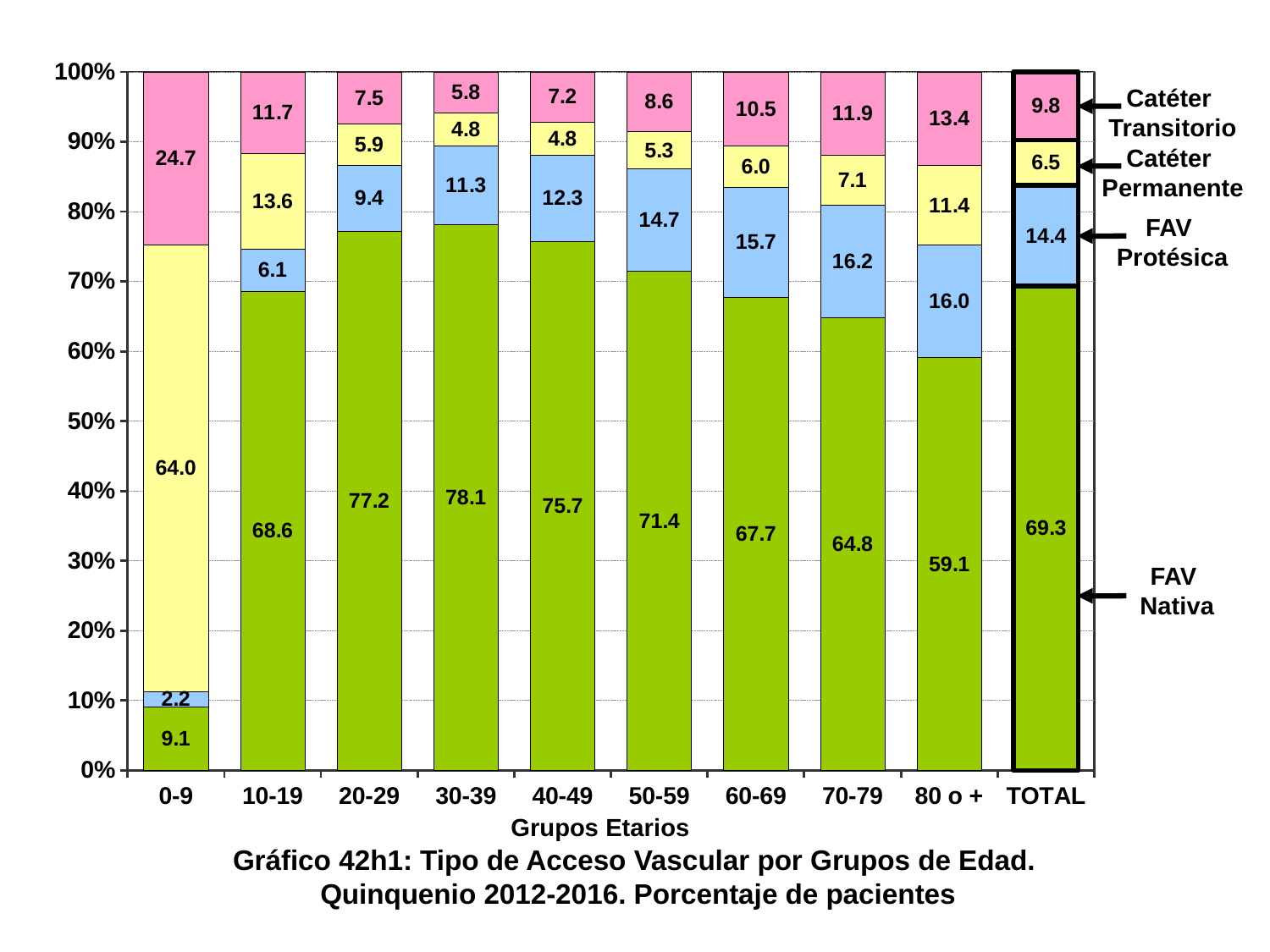
What is the FAV Nativa value for the 30-39 age group? 78.1 How many series (access types) are labelled on the chart? 4 What is the x-axis title of the chart? Grupos Etarios What kind of chart is this? Stacked bar chart Which age group has the lowest FAV Nativa value? 0-9 Which age group has the highest FAV Nativa value? 30-39 What is the difference between the FAV Nativa values for 20-29 and 80 o +? 18.1 What is the Catéter Transitorio value for the 0-9 age group? 24.7 How many bars are shown on the x axis, including TOTAL? 10 From the 30-39 group to the 80 o + group, does the FAV Nativa value rise or fall? Fall Which is larger, the Catéter Permanente value for 10-19 or for 80 o +? 10-19 What is the FAV Protésica value for the TOTAL bar? 14.4